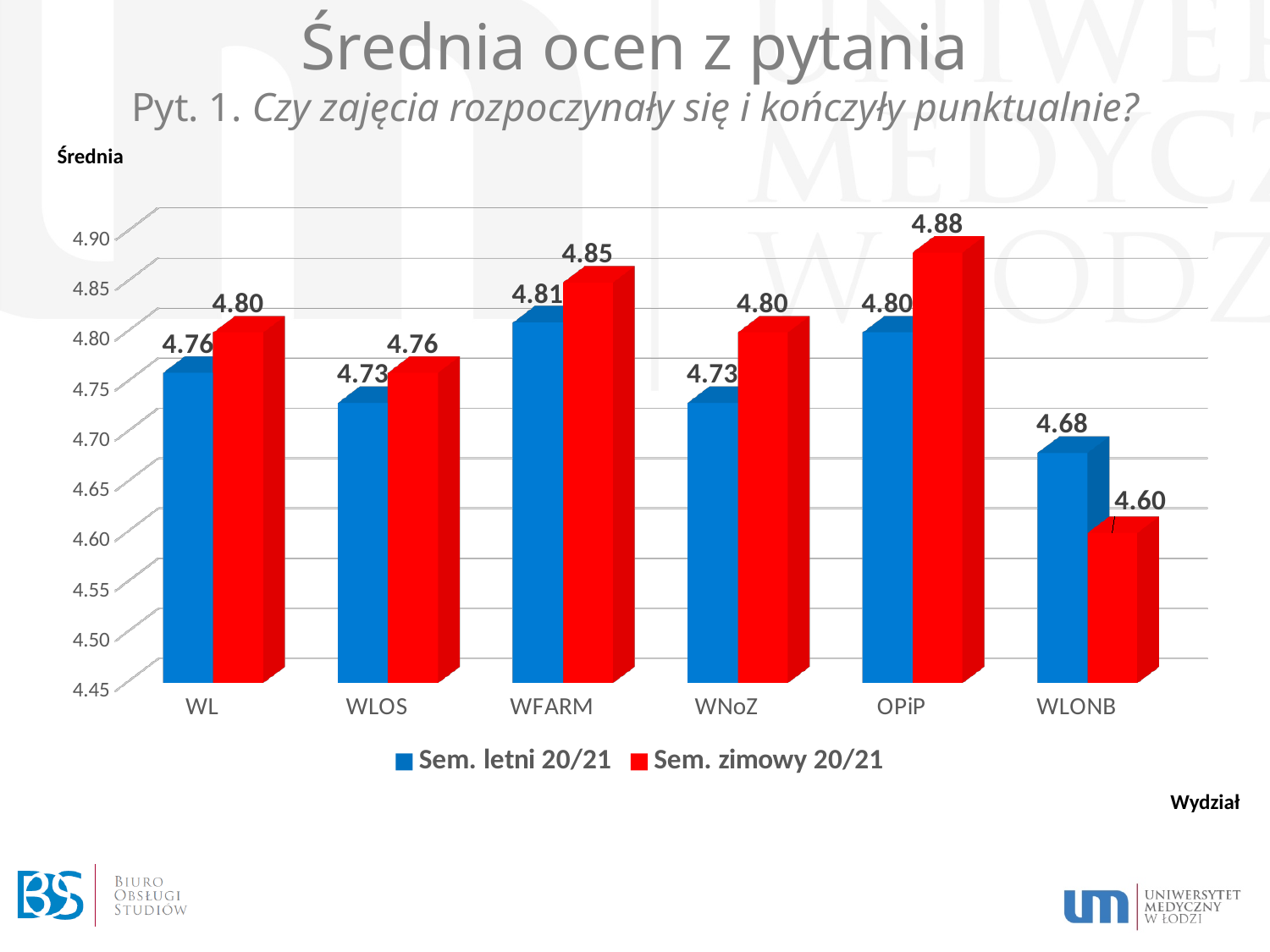
Which colour represents the Sem. zimowy 20/21 series? Red How many faculties are shown on the x axis? 6 What is the value for WFARM in the Sem. zimowy 20/21 series? 4.85 What is the value for WNoZ in the Sem. letni 20/21 series? 4.73 What is the value for WLONB in the Sem. letni 20/21 series? 4.68 What kind of chart is shown on the slide? Bar chart For WLONB, which series has the larger value: Sem. letni 20/21 or Sem. zimowy 20/21? Sem. letni 20/21 How many series does the legend list? 2 Which faculty has the lowest value in the Sem. letni 20/21 series? WLONB What is the difference between the Sem. zimowy 20/21 and Sem. letni 20/21 values for OPiP? 0.08 Which faculty has the highest value in the Sem. zimowy 20/21 series? OPiP What is the difference between the Sem. zimowy 20/21 values for OPiP and WLONB? 0.28